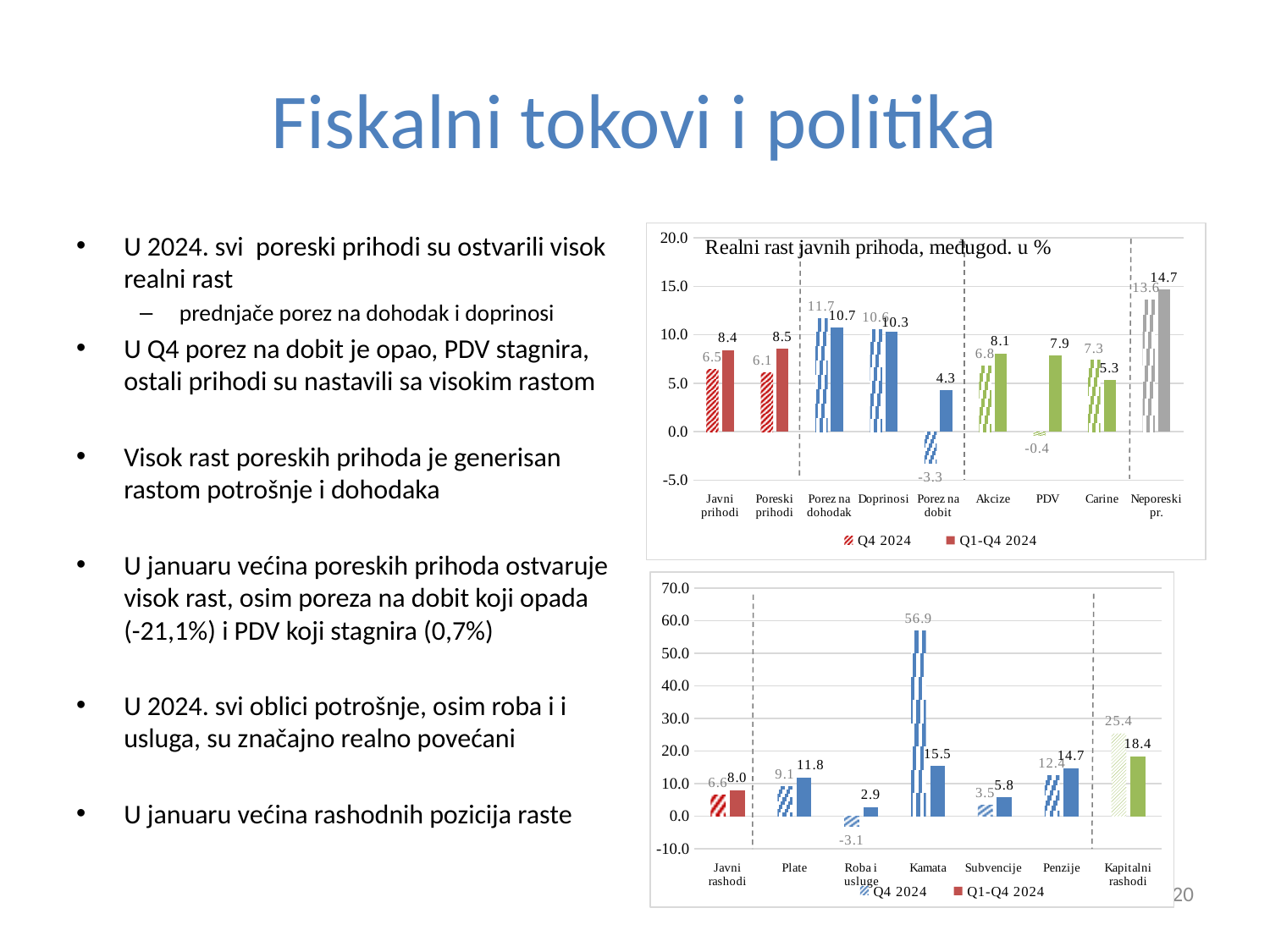
In the bottom chart, which category has the highest Q1-Q4 2024 value? Kapitalni rashodi In the top chart 'Realni rast javnih prihoda, međugod. u %', how many series does the legend list? 2 In the top chart 'Realni rast javnih prihoda, međugod. u %', how many categories are shown on the x axis? 9 In the top chart 'Realni rast javnih prihoda, međugod. u %', which category has the lowest Q4 2024 value? Porez na dobit In the bottom chart, what is the Q4 2024 value for Kamata? 56.9 In the top chart 'Realni rast javnih prihoda, međugod. u %', what is the difference between the Q4 2024 and Q1-Q4 2024 values for PDV? 8.3 In the top chart 'Realni rast javnih prihoda, međugod. u %', which category has the highest Q1-Q4 2024 value? Neporeski pr. What type of chart is the bottom chart? Bar chart In the top chart 'Realni rast javnih prihoda, međugod. u %', what is the Q1-Q4 2024 value for Javni prihodi? 8.4 In the top chart 'Realni rast javnih prihoda, međugod. u %', what is the Q4 2024 value for Porez na dobit? -3.3 In the bottom chart, which is larger for Plate: the Q4 2024 value or the Q1-Q4 2024 value? Q1-Q4 2024 In the bottom chart, what is the difference between the Q4 2024 and Q1-Q4 2024 values for Kamata? 41.4